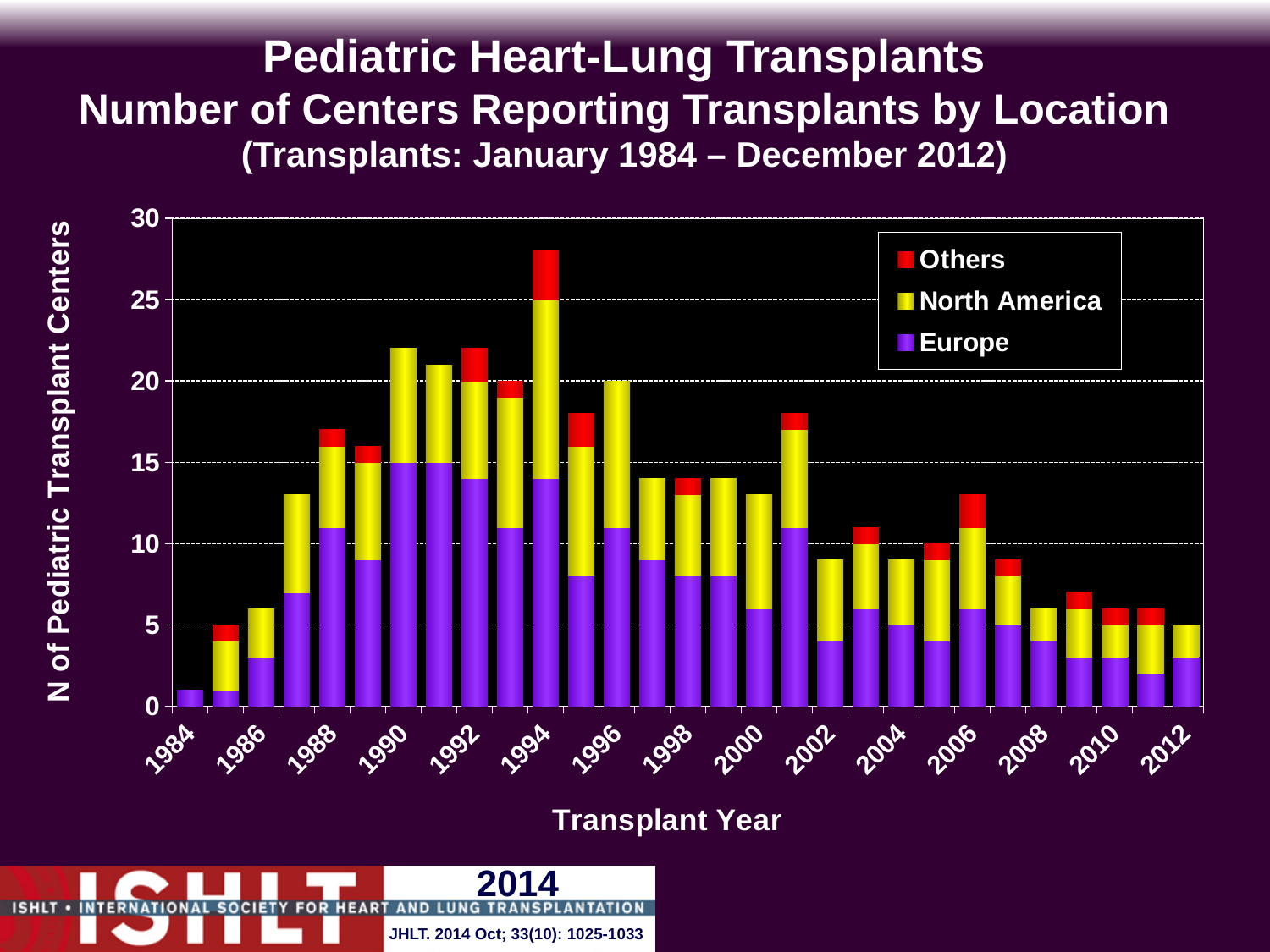
Is the total number of centers for 2012 greater or less than 10? less Which year has a larger total number of centers, 1990 or 2010? 1990 What kind of chart is shown on the slide? Stacked bar chart Is the total number of centers for 1994 greater or less than 25? greater Which colour represents Europe in the legend? Purple Which transplant year has the lowest total number of pediatric transplant centers? 1984 How many transplant years (bars) are plotted on the chart? 29 Do the total numbers of centers generally rise or fall from 2001 to 2012? fall Is the total number of centers for 1990 greater or less than 20? greater Which transplant year has the highest total number of pediatric transplant centers? 1994 How many series does the legend list? 3